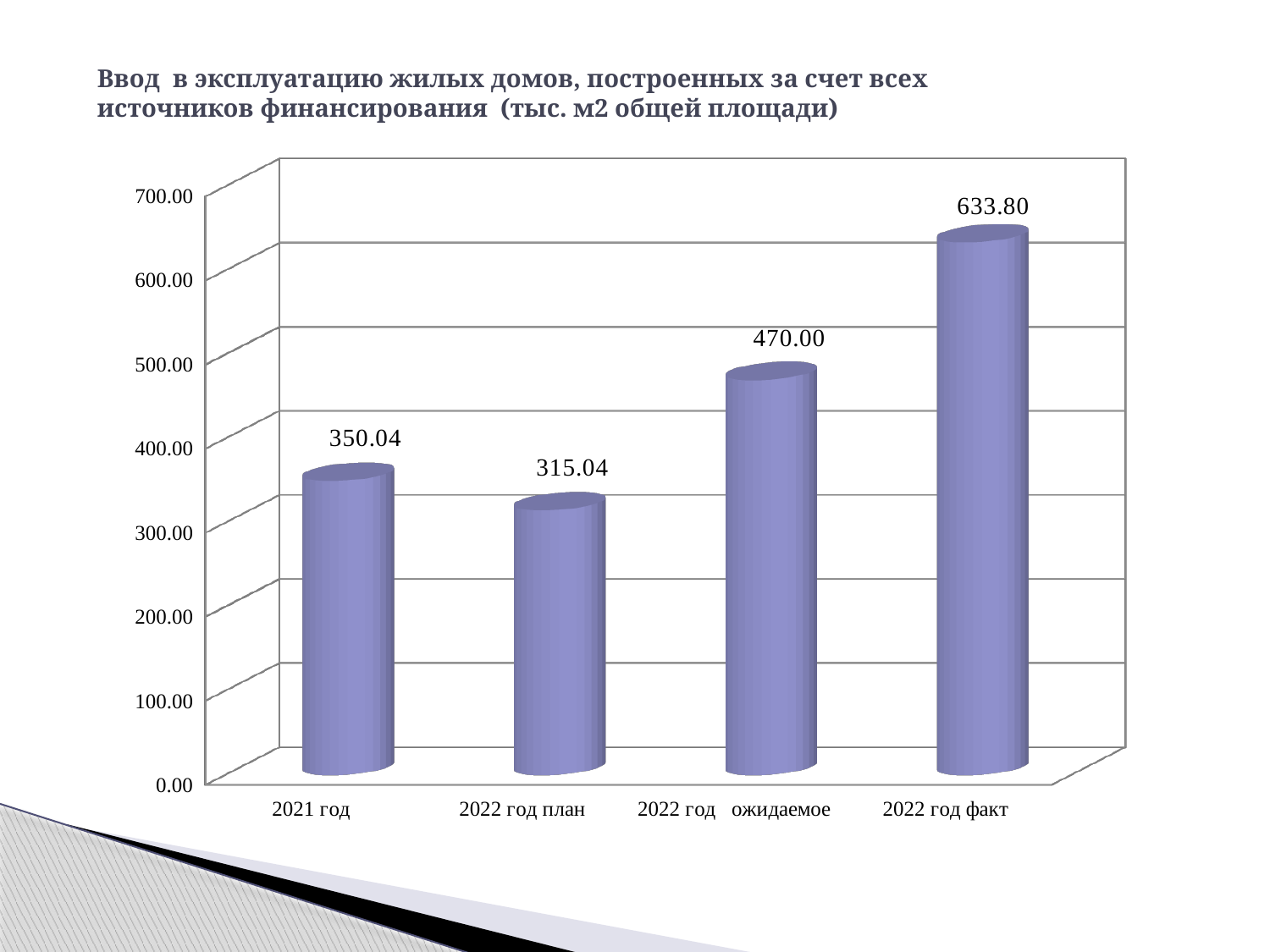
Is the value for 2022 год факт greater or less than 600.00? greater Which is larger, the value for 2022 год ожидаемое or the value for 2021 год? 2022 год ожидаемое Which category has the lowest value? 2022 год план What kind of chart is shown on the slide? bar chart What is the value for 2022 год факт? 633.80 What is the difference between the values for 2022 год факт and 2022 год план? 318.76 What is the value for 2022 год план? 315.04 How many categories are shown on the chart? 4 Which category has the highest value? 2022 год факт What is the value for 2022 год ожидаемое? 470.00 What is the value for 2021 год? 350.04 What is the difference between the values for 2021 год and 2022 год план? 35.00